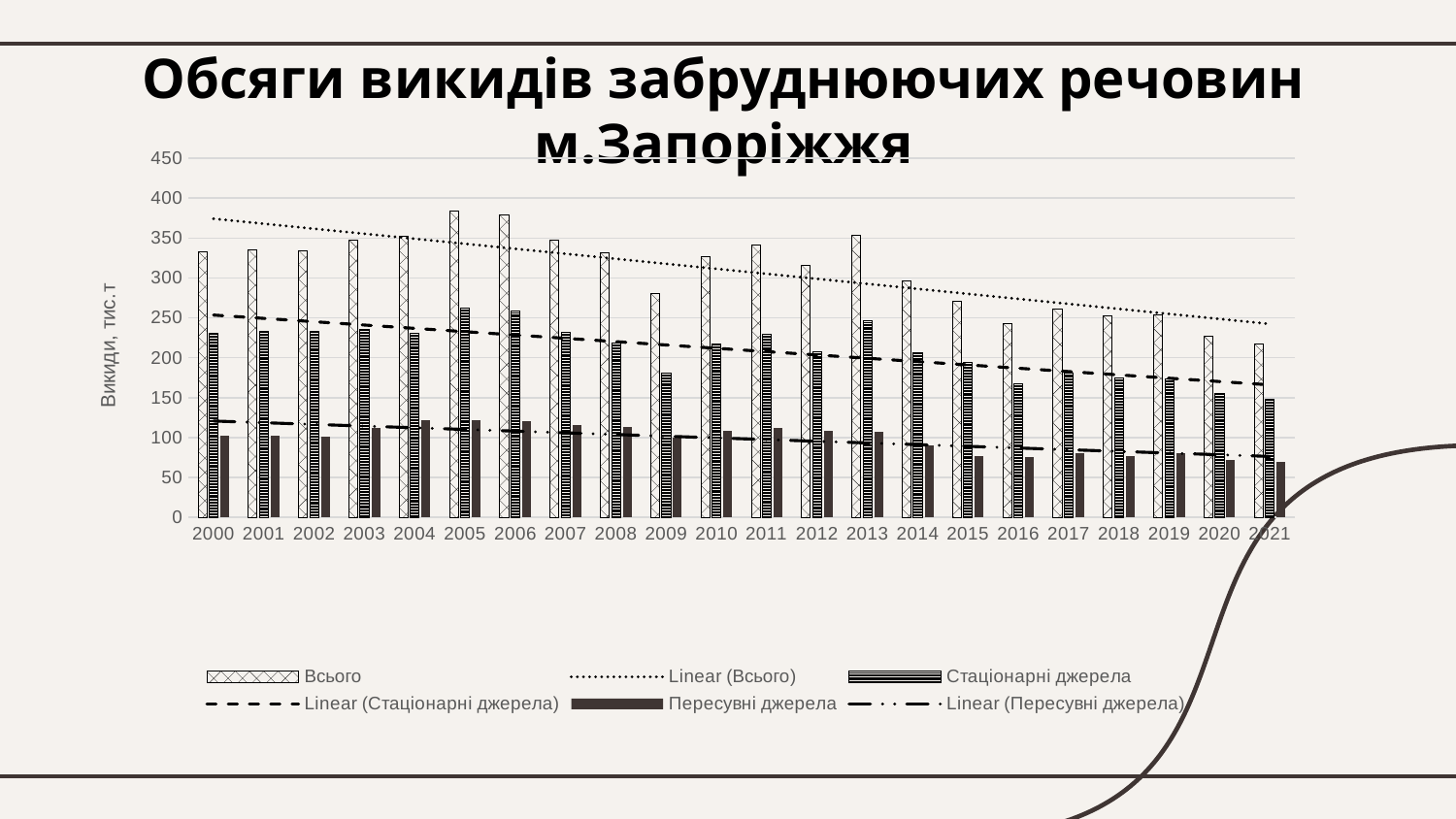
What kind of chart is shown on the slide? bar chart What is the label of the vertical axis? Викиди, тис.т Is the value for Всього in 2005 greater or less than 350? greater Which is larger, the Стаціонарні джерела value for 2013 or for 2020? 2013 What is the title of the chart? Обсяги викидів забруднюючих речовин м.Запоріжжя Do the Всього values generally rise or fall from 2000 to 2021? fall Which is larger, the Всього value for 2005 or for 2015? 2005 How many entries does the chart's legend list? 6 Is the value for Всього in 2021 greater or less than 250? less Is the value for Стаціонарні джерела in 2000 greater or less than 200? greater How many years are shown along the x axis of the chart? 22